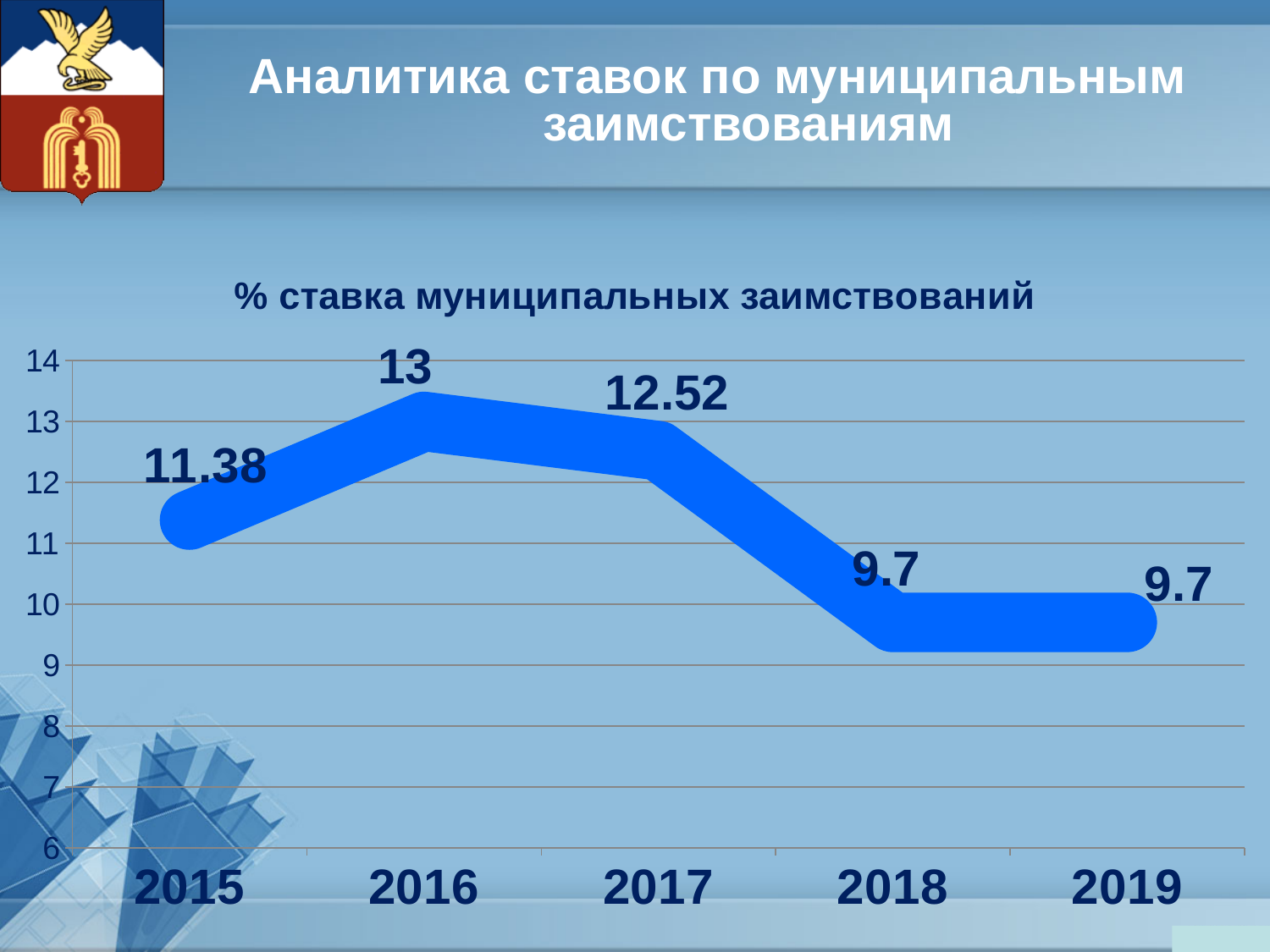
What is the value for 2015? 11.38 What is the title of the chart? % ставка муниципальных заимствований How many years are plotted on the chart? 5 What is the difference between the values for 2017 and 2018? 2.82 Which year has the highest value? 2016 What is the value for 2018? 9.7 What is the difference between the values for 2016 and 2017? 0.48 What is the value for 2017? 12.52 Is the value for 2019 greater or less than 10? less Which is larger, the value for 2015 or the value for 2017? 2017 What is the value for 2016? 13 What kind of chart is shown on the slide? line chart